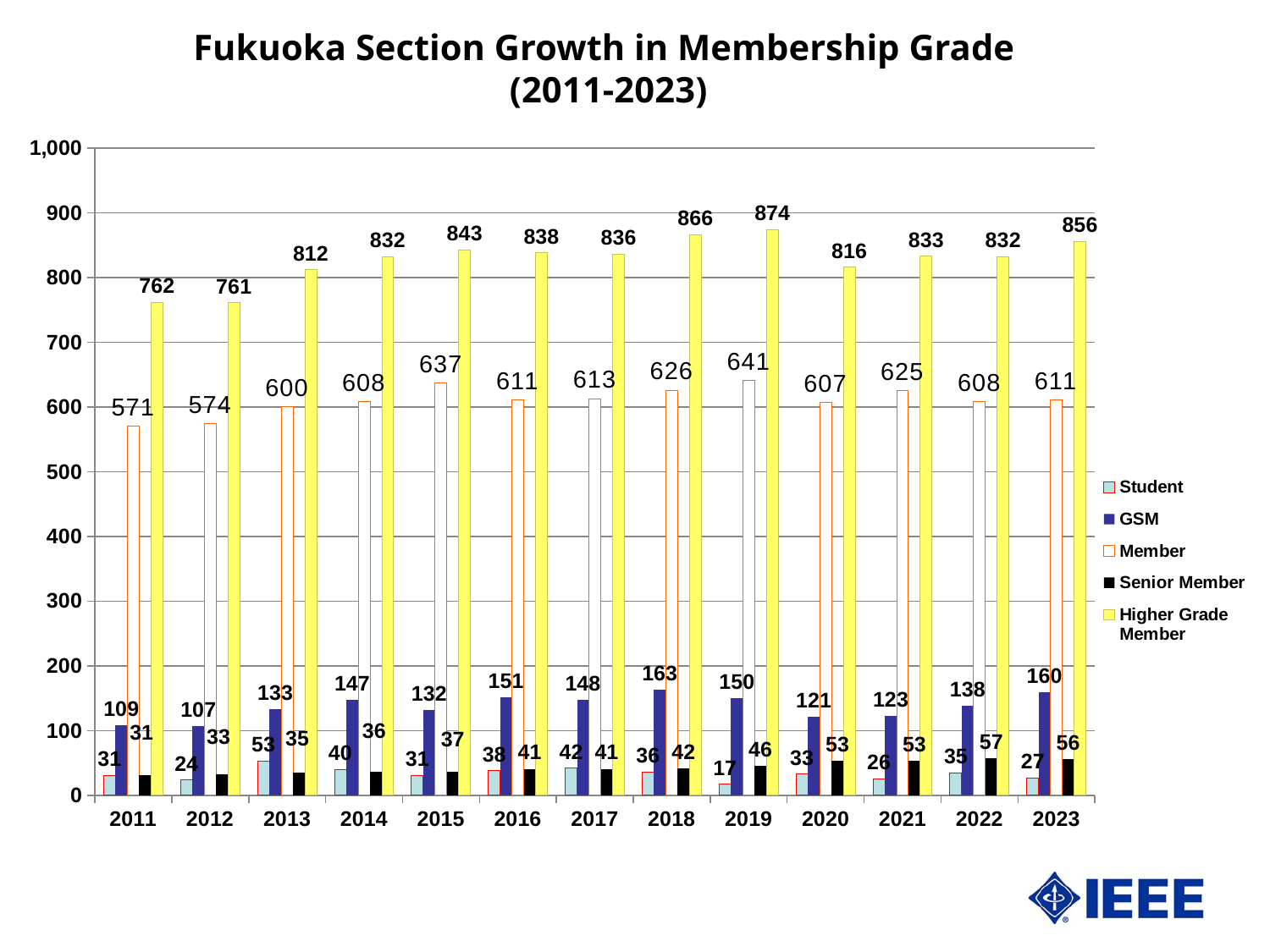
In which year is the Higher Grade Member value highest? 2019 How many series does the legend list? 5 What is the Member value for 2013? 600 Which year has the larger Member value, 2015 or 2019? 2019 How many years are shown on the x axis? 13 In which year is the Student value lowest? 2019 In which year is the GSM value highest? 2018 What is the title of the chart? Fukuoka Section Growth in Membership Grade (2011-2023) What is the difference between the GSM value in 2023 and the GSM value in 2011? 51 What kind of chart is shown on the slide? Bar chart What is the value for Higher Grade Member in 2019? 874 Does the Senior Member value generally rise or fall from 2011 to 2023? Rise